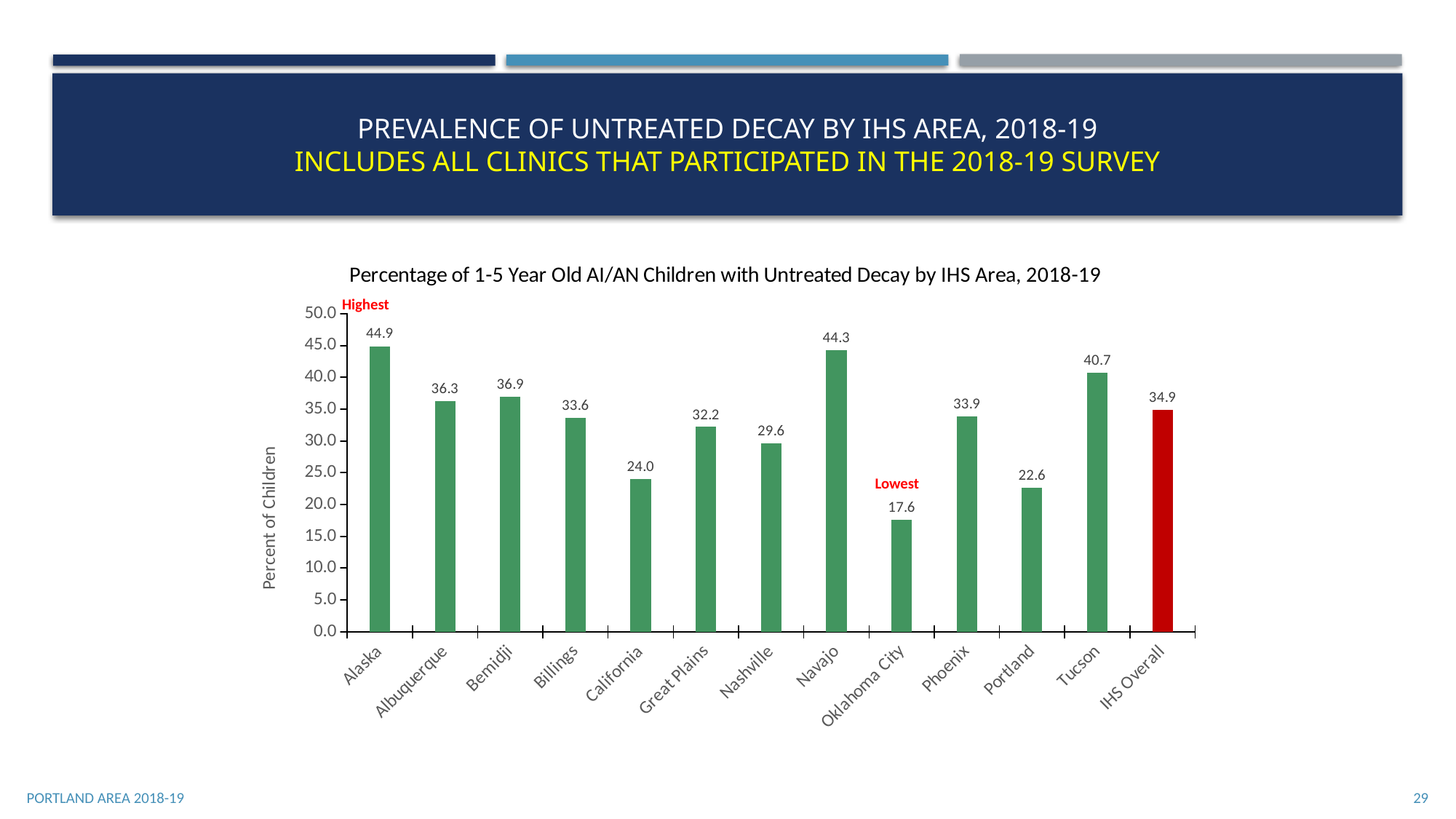
Which IHS area has the lowest percentage of children with untreated decay? Oklahoma City What is the value for Alaska? 44.9 What is the label of the y axis? Percent of Children What is the value for Oklahoma City? 17.6 Which IHS area has the highest percentage of children with untreated decay? Alaska What kind of chart is shown on the slide? Bar chart What is the difference between the values for Alaska and Oklahoma City? 27.3 Which is larger, the value for Navajo or the value for Tucson? Navajo What is the value for IHS Overall? 34.9 What is the difference between the values for Tucson and Portland? 18.1 How many categories are shown on the x axis? 13 What is the value for Portland? 22.6